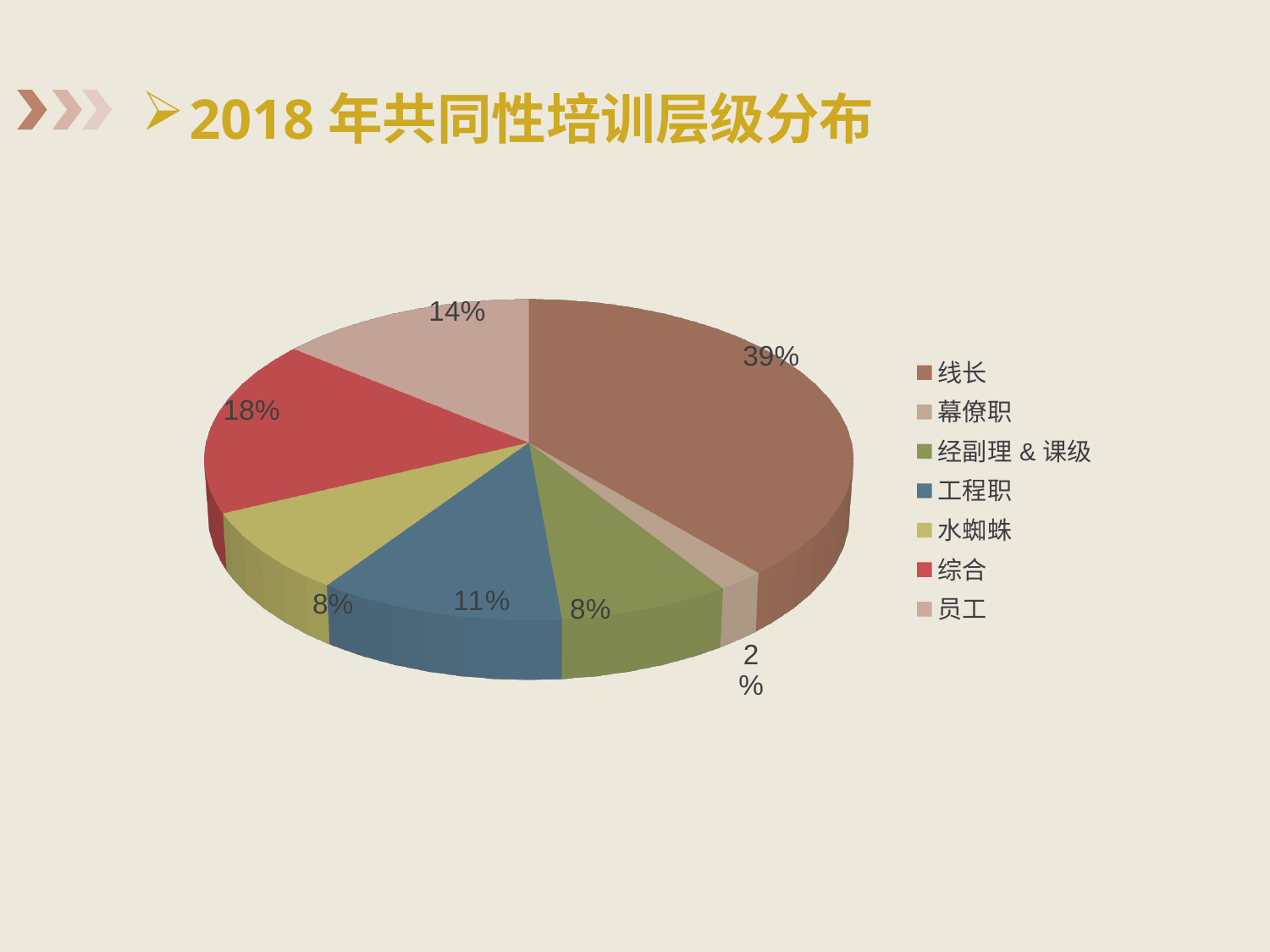
How many categories does the legend list? 7 What percentage is shown for 员工? 14% What is the difference in percentage points between 线长 and 综合? 21 What percentage is shown for 综合? 18% Which is larger, the share for 工程职 or the share for 员工? 员工 What share of the pie does 线长 hold? 39% What percentage is shown for 工程职? 11% What is the title of the slide? 2018 年共同性培训层级分布 What kind of chart is shown on the slide? Pie chart What percentage is shown for 幕僚职? 2% Which category has the largest share of the pie? 线长 Which category has the smallest share of the pie? 幕僚职